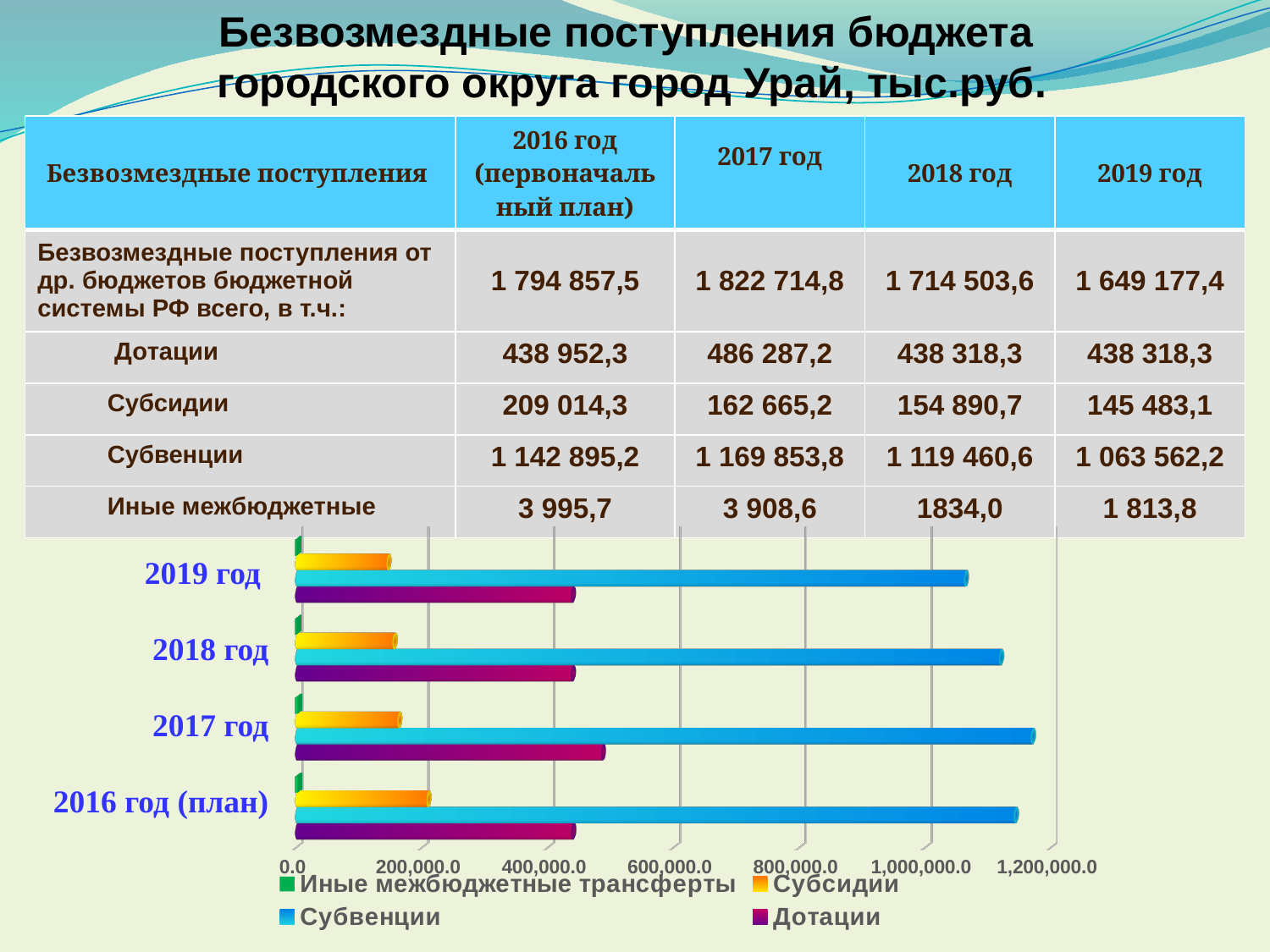
Is the value of the Субсидии bar for 2019 год greater or less than 200,000.0? less Is the value of the Дотации bar for 2017 год greater or less than 400,000.0? greater Which series has the shortest bars in every year on the chart? Иные межбюджетные трансферты According to the table, what is the value of Дотации for 2017 год? 486 287,2 How many year categories are plotted on the chart? 4 Using the table values, what is the difference between Субсидии in 2016 год (первоначальный план) and in 2019 год? 63 531,2 Which is larger on the chart: the Дотации bar for 2017 год or the Дотации bar for 2019 год? 2017 год Is the value of the Субвенции bar for 2019 год greater or less than 1,000,000.0? greater Do the Субсидии values rise or fall from 2016 год (план) to 2019 год? fall What kind of chart is shown below the table on the slide? bar chart How many series does the chart legend list? 4 Which series has the longest bars in every year on the chart? Субвенции